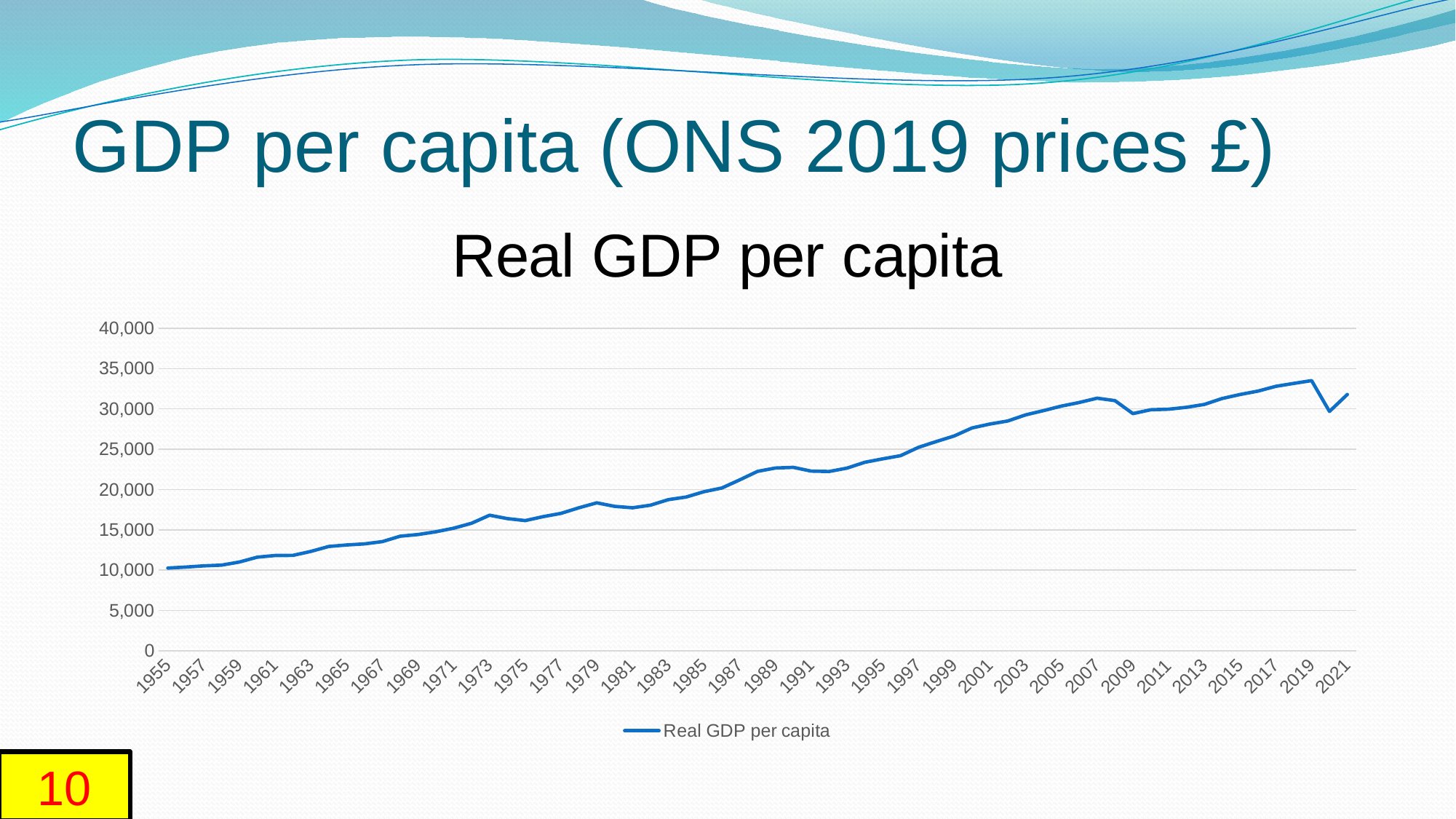
What kind of chart is shown on the slide? line chart Is the value for 1989 greater or less than 20,000? greater How many series does the legend list? 1 Which year has the larger real GDP per capita, 1973 or 1975? 1973 Is the value for 2019 greater or less than 30,000? greater In which year is real GDP per capita lowest? 1955 Which year has the larger real GDP per capita, 2007 or 2009? 2007 What is the title of the chart? Real GDP per capita What is the name of the series shown in the legend? Real GDP per capita In which year is real GDP per capita highest? 2019 Overall, does real GDP per capita rise or fall from 1955 to 2021? rise Is the value for 1955 greater or less than 15,000? less